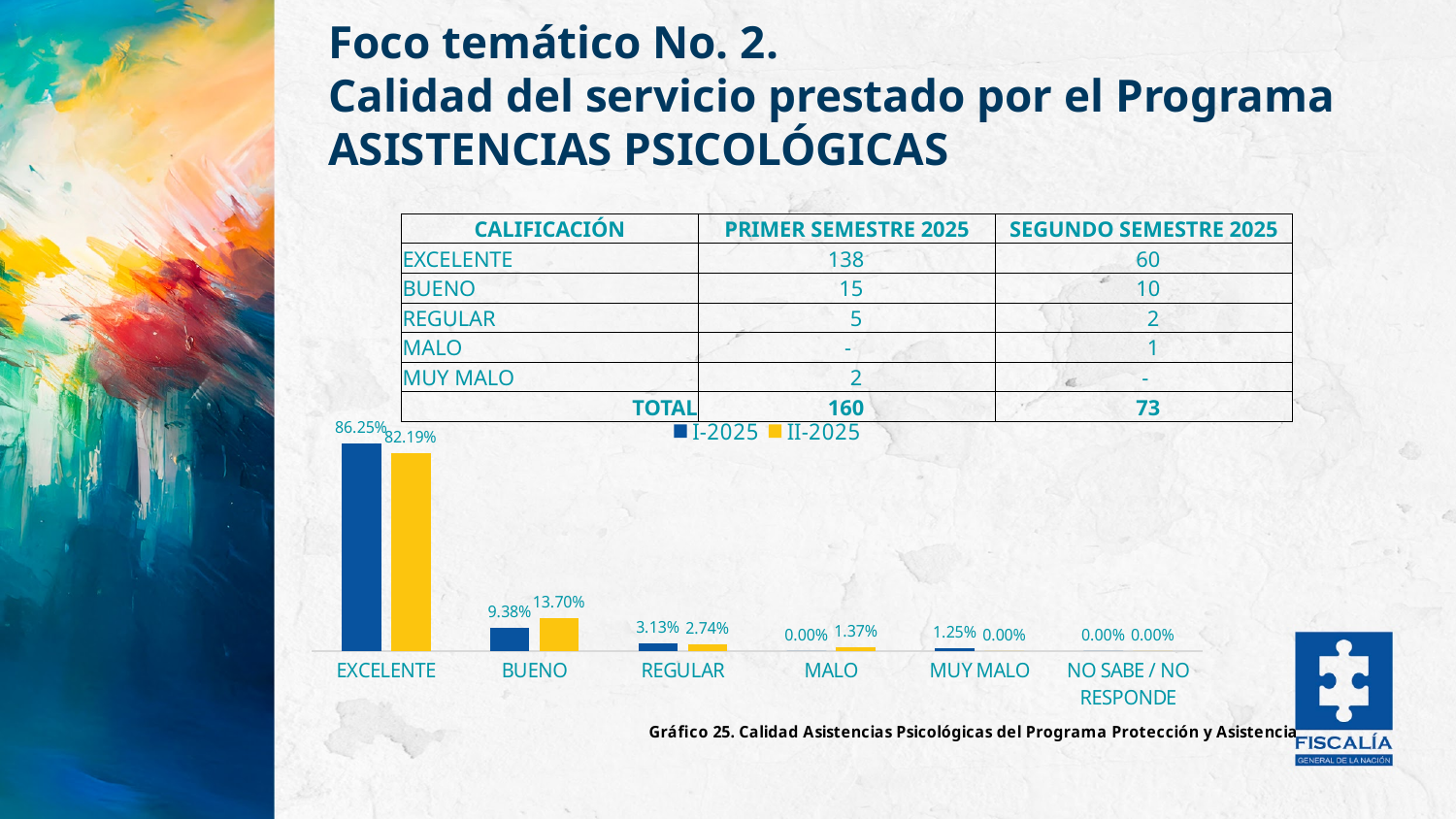
What is the value for MUY MALO in the I-2025 series? 1.25% What is the value for BUENO in the II-2025 series? 13.70% What is the caption of the chart? Gráfico 25. Calidad Asistencias Psicológicas del Programa Protección y Asistencia What is the value for MALO in the II-2025 series? 1.37% How many series does the chart legend list? 2 Which category has the highest value in the I-2025 series? EXCELENTE Which category has the lowest value in the II-2025 series, other than those at 0.00%? MALO What is the value for EXCELENTE in the I-2025 series? 86.25% How many categories are shown on the x axis of the chart? 6 What is the difference between the I-2025 and II-2025 values for EXCELENTE? 4.06 percentage points Which is larger for BUENO: the I-2025 value or the II-2025 value? II-2025 What kind of chart is shown on the slide? Bar chart